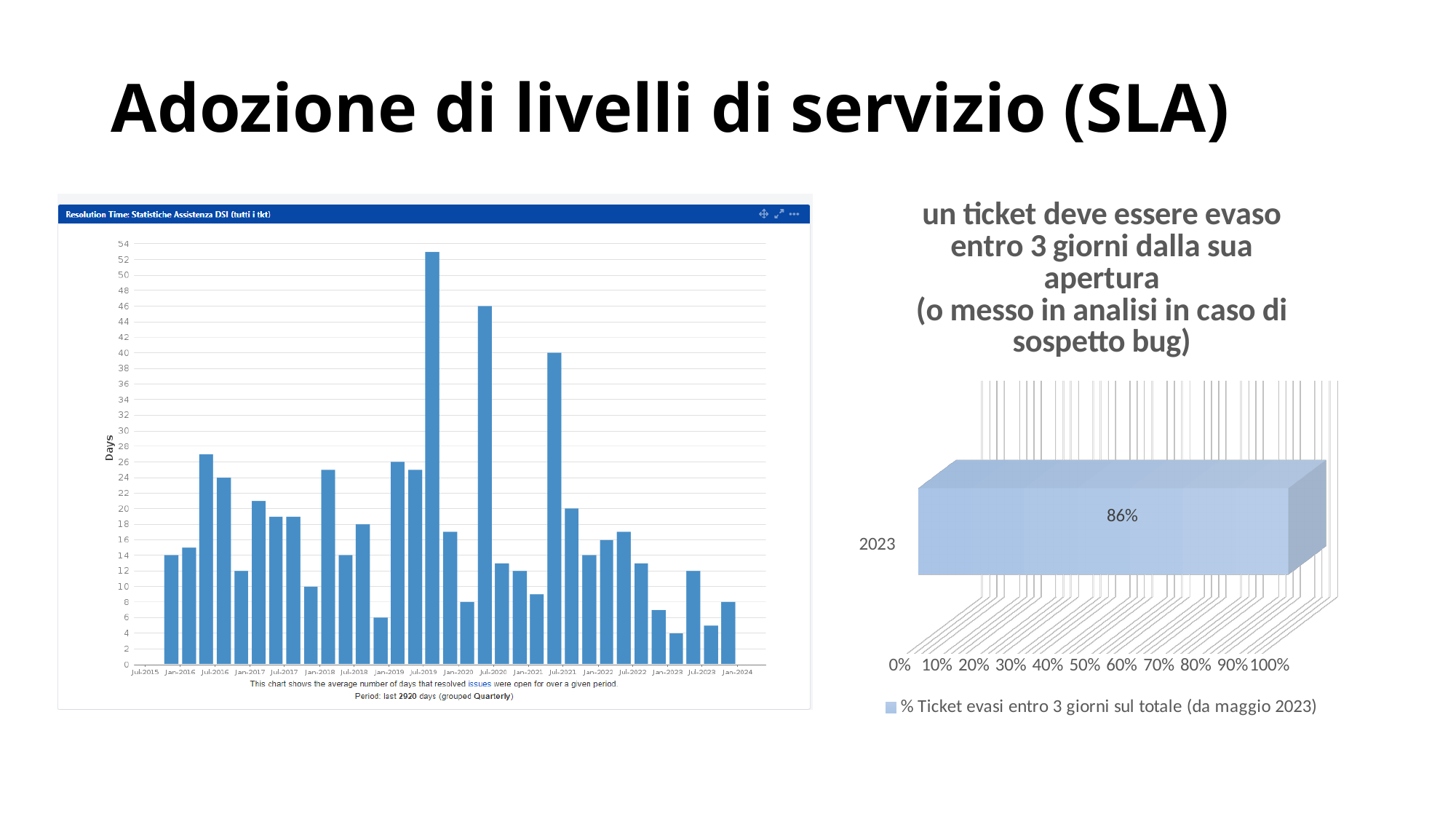
On the left chart 'Resolution Time', is the tallest bar greater or less than 50 days? greater How many categories are plotted on the right chart? 1 On the right chart, is the value for 2023 greater or less than 90%? less On the left chart 'Resolution Time', what is the label of the y axis? Days What kind of chart is the right chart? Bar chart How many series does the legend of the right chart list? 1 On the right chart, what is the value shown for 2023? 86% On the left chart 'Resolution Time', around which x-axis label does the tallest bar appear? Jul-2019 What is the legend entry of the right chart? % Ticket evasi entro 3 giorni sul totale (da maggio 2023) What kind of chart is the left chart titled 'Resolution Time: Statistiche Assistenza DSI (tutti i tkt)'? Bar chart On the right chart, is the value for 2023 greater or less than 80%? greater